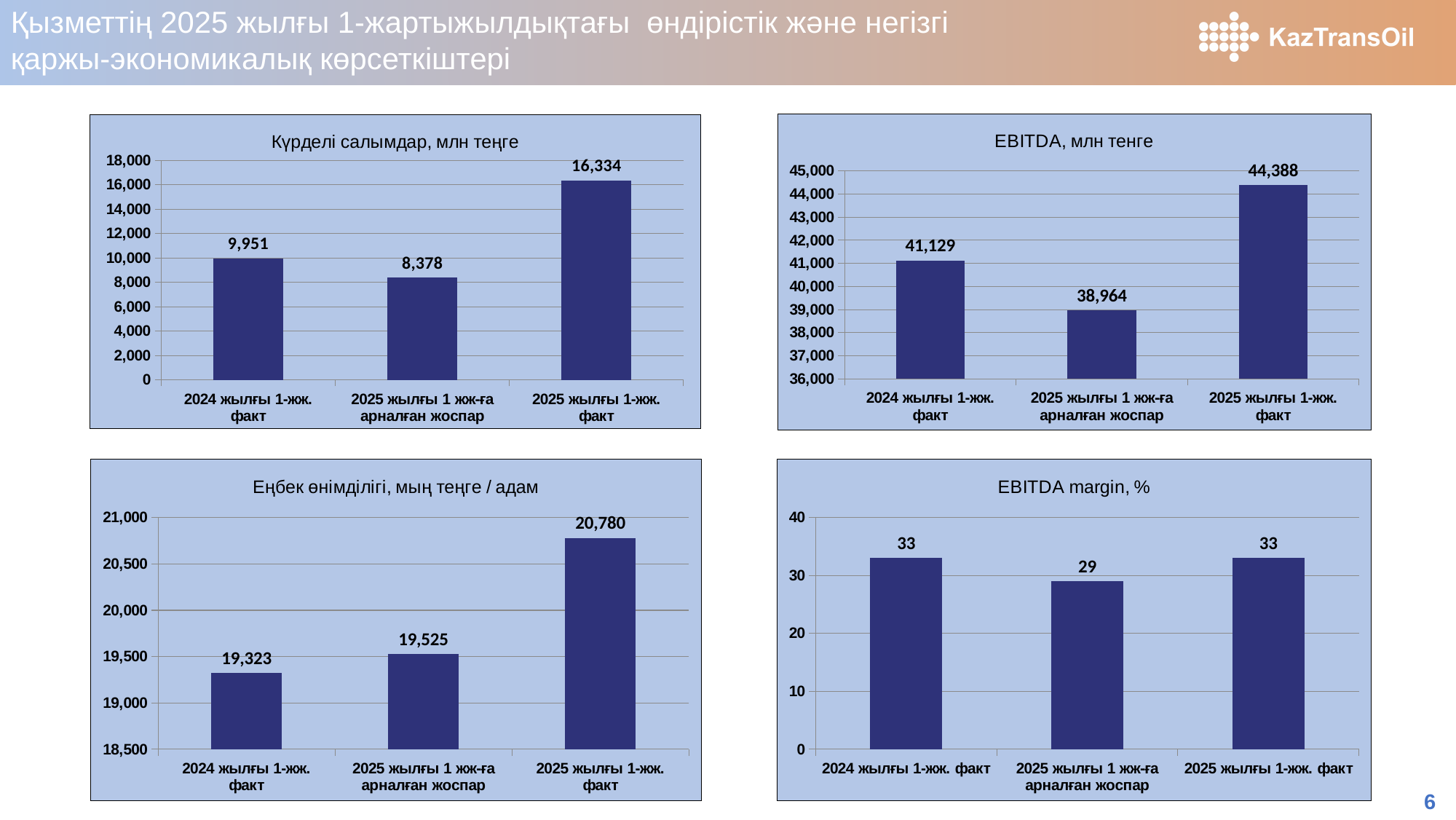
How many categories are shown in the 'EBITDA margin, %' chart? 3 In the 'Еңбек өнімділігі, мың теңге / адам' chart, what is the value for '2024 жылғы 1-жж. факт'? 19,323 In the 'Күрделі салымдар, млн теңге' chart, which category has the lowest value? 2025 жылғы 1 жж-ға арналған жоспар In the 'EBITDA, млн тенге' chart, which category has the highest value? 2025 жылғы 1-жж. факт In the 'Күрделі салымдар, млн теңге' chart, what is the value for '2025 жылғы 1-жж. факт'? 16,334 In the 'Күрделі салымдар, млн теңге' chart, what is the difference between '2025 жылғы 1-жж. факт' and '2024 жылғы 1-жж. факт'? 6,383 What type of chart is the 'EBITDA, млн тенге' chart? bar chart In the 'EBITDA margin, %' chart, what is the value for '2025 жылғы 1 жж-ға арналған жоспар'? 29 In the 'EBITDA, млн тенге' chart, what is the value for '2025 жылғы 1 жж-ға арналған жоспар'? 38,964 In the 'EBITDA, млн тенге' chart, what is the difference between '2025 жылғы 1-жж. факт' and '2025 жылғы 1 жж-ға арналған жоспар'? 5,424 In the 'Еңбек өнімділігі, мың теңге / адам' chart, which is larger: '2025 жылғы 1 жж-ға арналған жоспар' or '2025 жылғы 1-жж. факт'? 2025 жылғы 1-жж. факт In the 'Еңбек өнімділігі, мың теңге / адам' chart, do the values rise or fall from left to right? rise